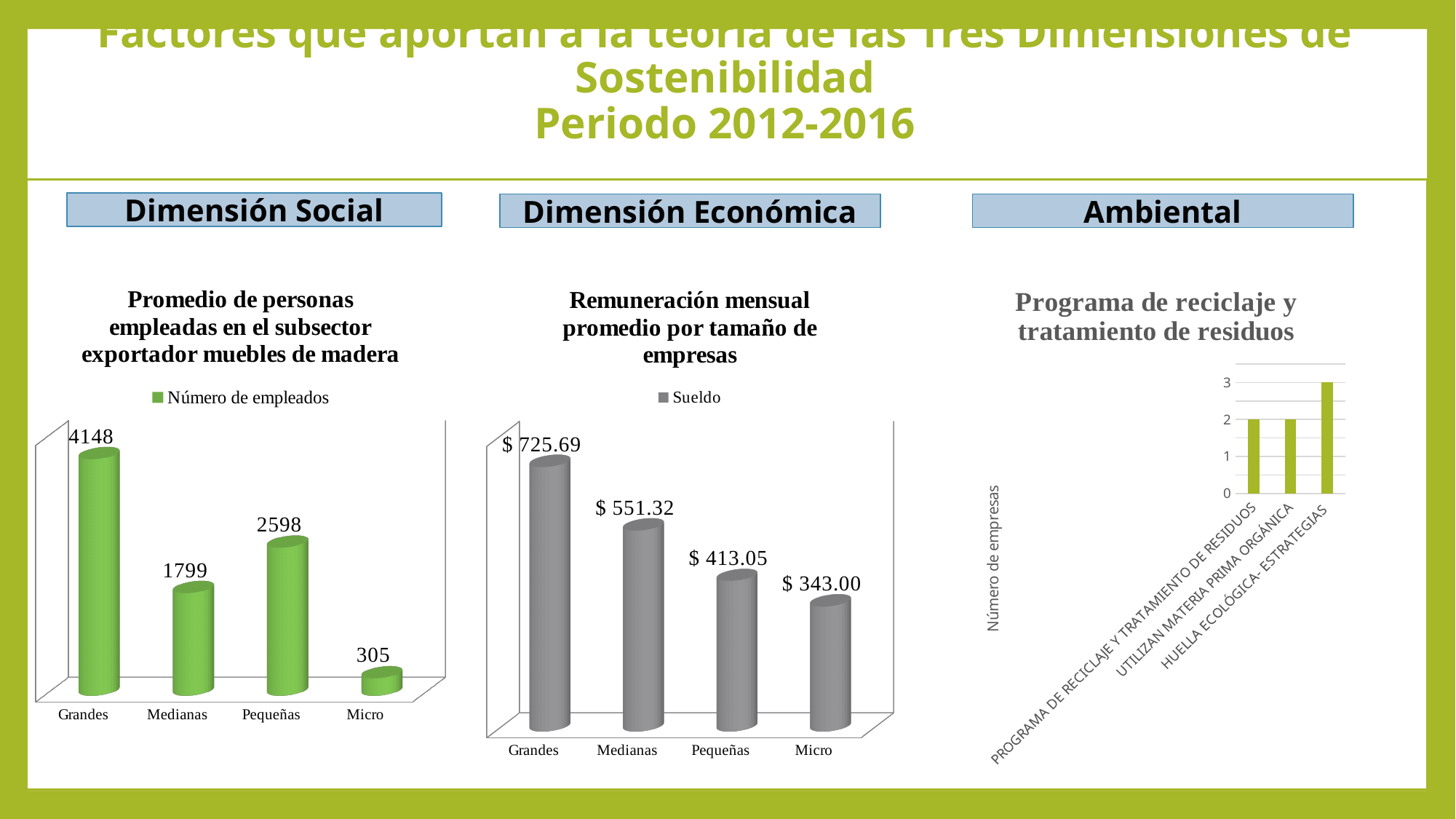
In the chart titled 'Remuneración mensual promedio por tamaño de empresas', what is the value for Medianas? $ 551.32 What kind of chart is the chart titled 'Promedio de personas empleadas en el subsector exportador muebles de madera'? bar chart In the chart titled 'Programa de reciclaje y tratamiento de residuos', what is the value for 'Huella ecológica- estrategias'? 3 In the chart titled 'Promedio de personas empleadas en el subsector exportador muebles de madera', which category has the lowest value? Micro In the chart titled 'Remuneración mensual promedio por tamaño de empresas', what series name does the legend show? Sueldo In the chart titled 'Programa de reciclaje y tratamiento de residuos', how many categories are shown on the x axis? 3 In the chart titled 'Remuneración mensual promedio por tamaño de empresas', do the values rise or fall from Grandes to Micro along the x axis? fall In the chart titled 'Promedio de personas empleadas en el subsector exportador muebles de madera', what is the difference between the values for Pequeñas and Medianas? 799 In the chart titled 'Remuneración mensual promedio por tamaño de empresas', which category has the highest value? Grandes In the chart titled 'Promedio de personas empleadas en el subsector exportador muebles de madera', what is the value for Grandes? 4148 In the chart titled 'Remuneración mensual promedio por tamaño de empresas', what is the difference between the values for Grandes and Micro? $ 382.69 In the chart titled 'Promedio de personas empleadas en el subsector exportador muebles de madera', which is larger, the value for Medianas or the value for Pequeñas? Pequeñas